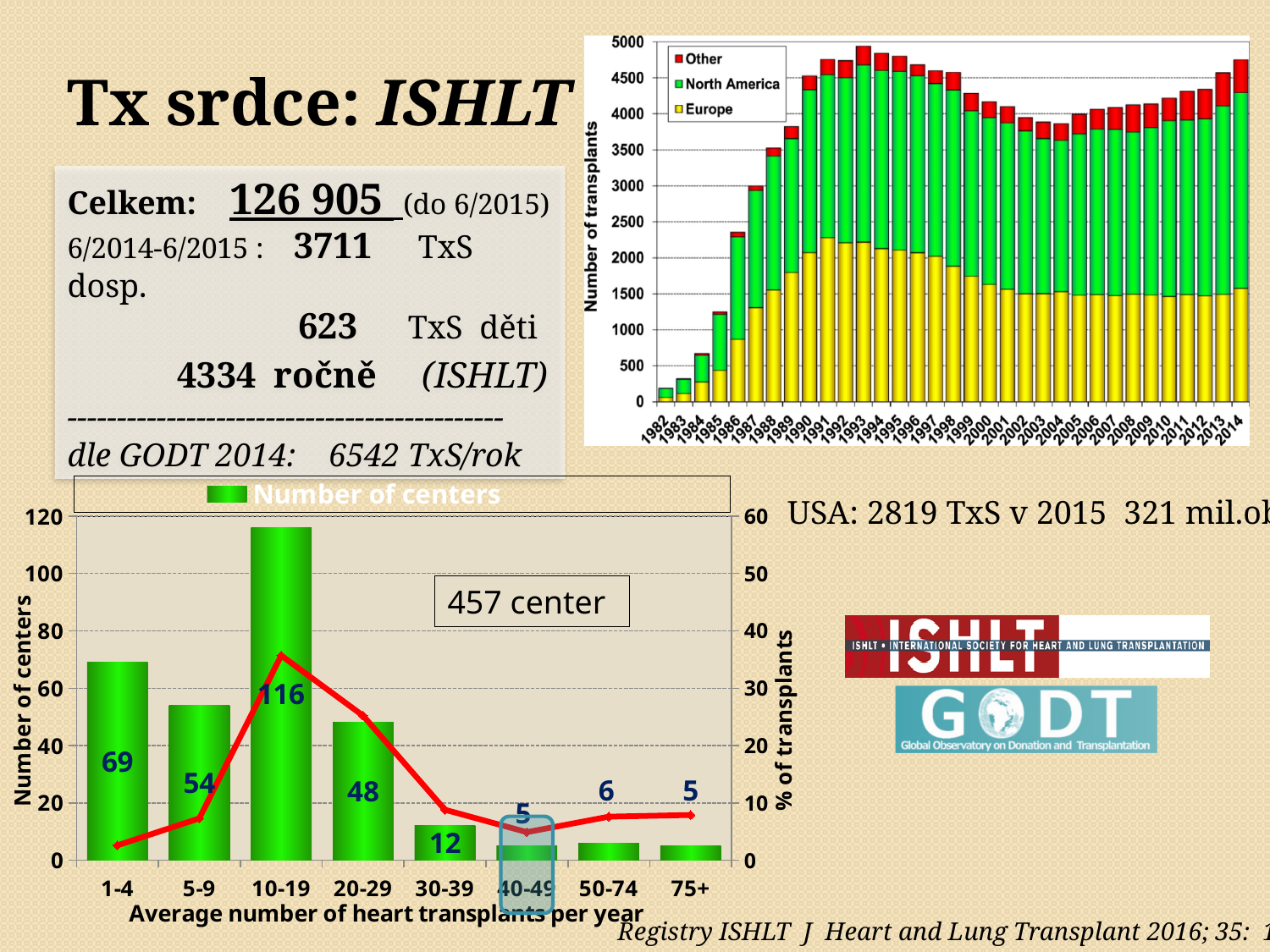
On the bottom-left chart, what is the number of centers in the 30-39 category? 12 What kind of chart is the top-right chart showing number of transplants by year? stacked bar chart On the top-right chart, do the total number of transplants rise or fall from 1982 to 1993? rise On the top-right chart, is the total number of transplants in 1982 greater or less than 500? less On the top-right chart, how many series does the legend list? 3 On the bottom-left chart, what is the difference in number of centers between the 10-19 and 1-4 categories? 47 On the bottom-left chart, what is the number of centers in the 1-4 category? 69 On the bottom-left chart, which category has more centers, 5-9 or 20-29? 5-9 On the bottom-left chart, how many centers perform 10-19 heart transplants per year on average? 116 On the bottom-left chart, how many categories are shown on the x axis? 8 On the bottom-left chart, what is the label of the x axis? Average number of heart transplants per year On the bottom-left chart, which category has the highest number of centers? 10-19